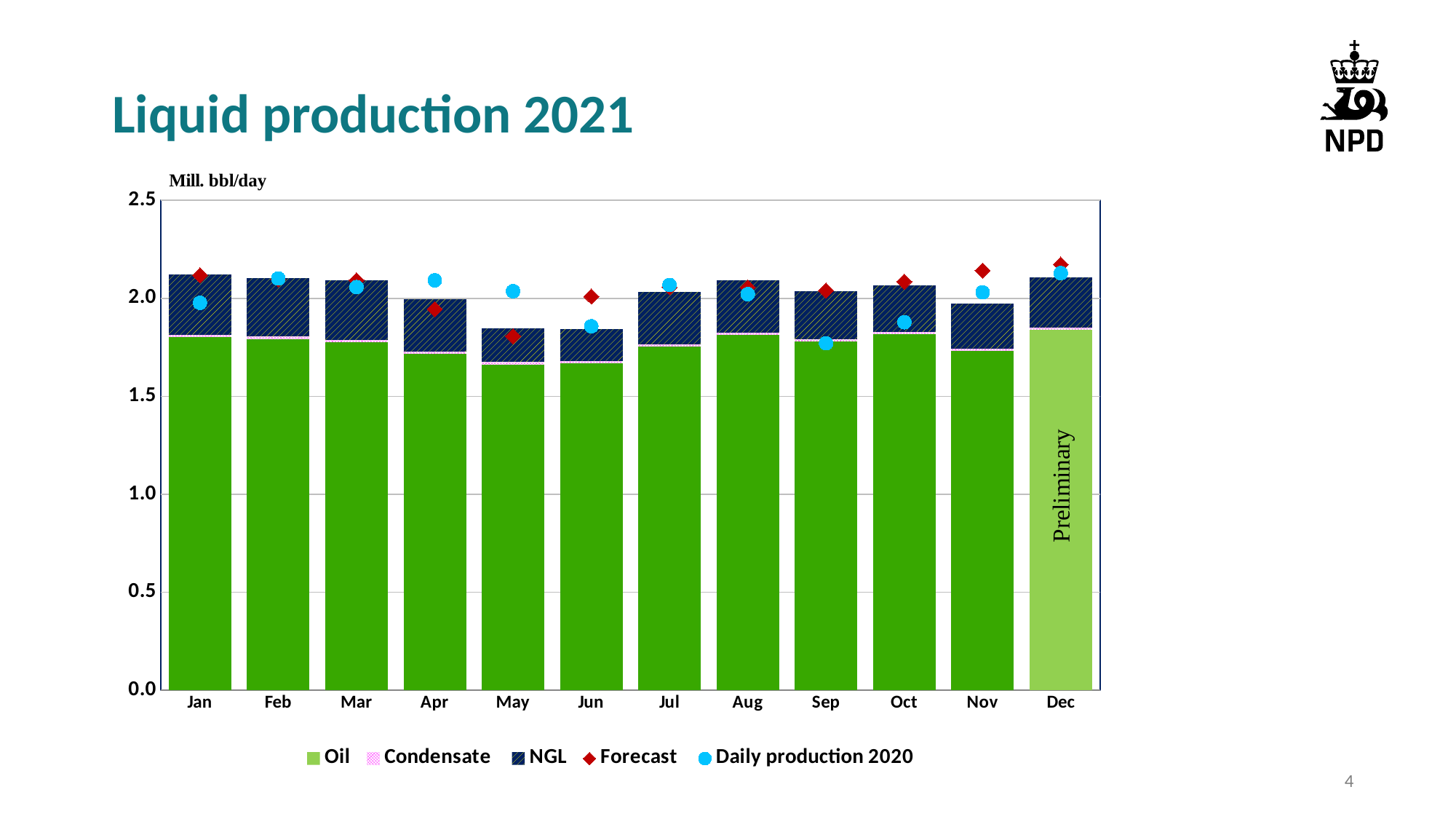
Which month has the higher Forecast marker, Nov or May? Nov Is the Daily production 2020 marker for Sep greater or less than 2.0? less Is the total liquid production bar for Jan greater or less than 2.0? greater How many months (categories) are shown on the x axis? 12 Which month has the larger total liquid production bar, Jan or May? Jan Which month's bar is marked as 'Preliminary'? Dec Is the total liquid production bar for May greater or less than 2.0? less How many series does the legend list? 5 What kind of chart is shown on the slide? Stacked bar chart What unit is shown on the y axis of the chart? Mill. bbl/day